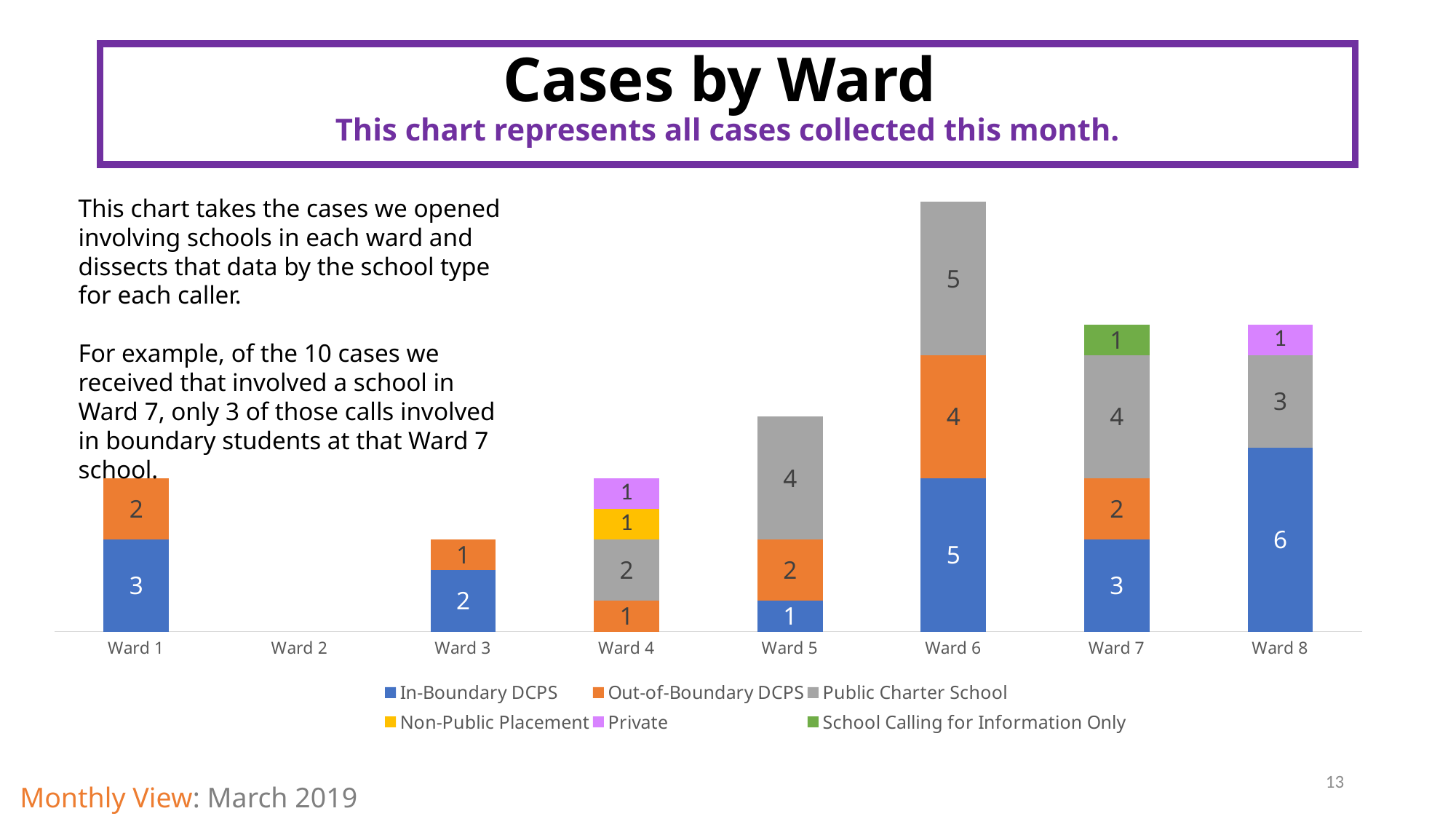
What is the Public Charter School value for Ward 6? 5 What type of chart is shown on the slide? Stacked bar chart What is the difference between the In-Boundary DCPS values for Ward 8 and Ward 7? 3 Which ward has the tallest stacked bar? Ward 6 How many series does the legend list? 6 What is the total of the stacked bar for Ward 6? 14 What is the In-Boundary DCPS value for Ward 8? 6 What is the Out-of-Boundary DCPS value for Ward 7? 2 How many wards are shown on the x axis? 8 Which ward has a School Calling for Information Only segment? Ward 7 Which is larger, the Public Charter School value for Ward 5 or for Ward 8? Ward 5 What is the total of the stacked bar for Ward 4? 5